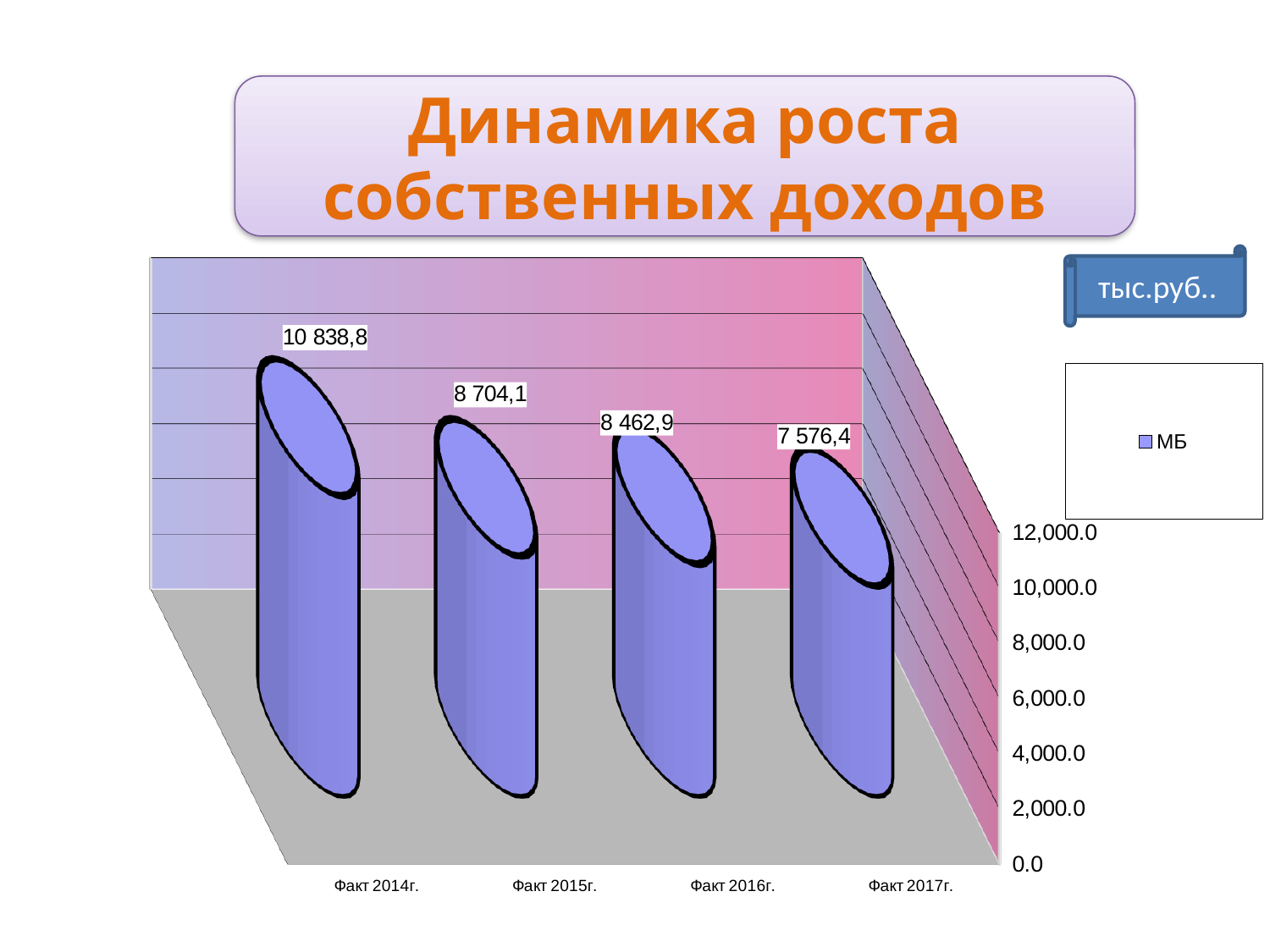
Which category has the highest value? Факт 2014г. What is the value for Факт 2016г.? 8 462,9 Which is larger, the value for Факт 2015г. or Факт 2016г.? Факт 2015г. What kind of chart is shown on the slide? Bar chart How many categories are shown on the x axis? 4 How many series does the legend list? 1 Do the values rise or fall from Факт 2014г. to Факт 2017г.? Fall What is the value for Факт 2014г.? 10 838,8 Which category has the lowest value? Факт 2017г. What is the difference between the values for Факт 2014г. and Факт 2015г.? 2 134,7 What is the value for Факт 2017г.? 7 576,4 What is the difference between the values for Факт 2016г. and Факт 2017г.? 886,5